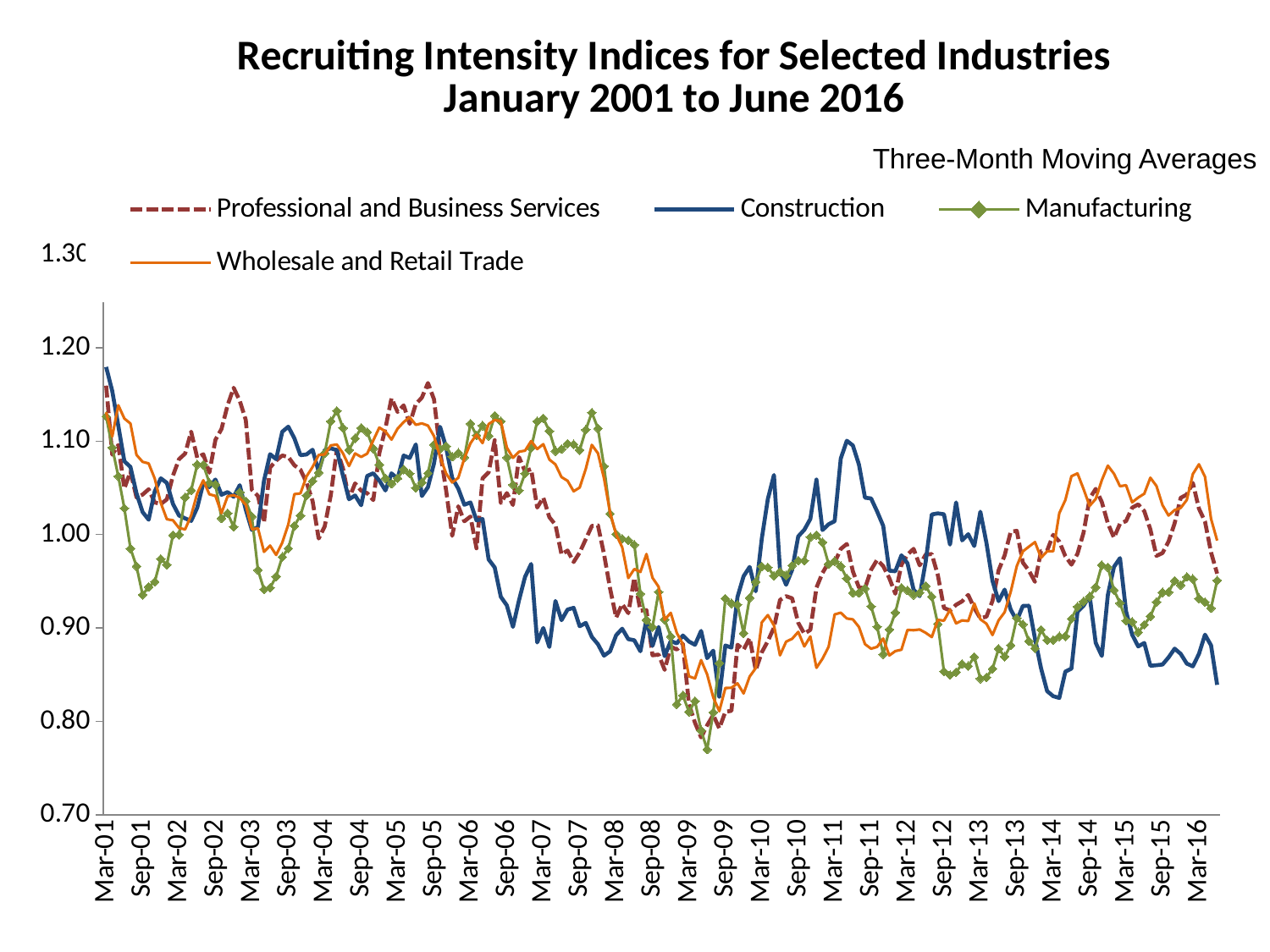
How many series does the legend list? 4 Is the value for Construction at Mar-01 greater or less than 1.10? greater What kind of chart is shown on the slide? line chart Does the Construction series overall rise or fall from Mar-01 to Mar-16? fall Which series is marked with diamond markers? Manufacturing At Sep-11, which is higher: Construction or Manufacturing? Construction Which series is drawn with a dashed line? Professional and Business Services Is the value for Manufacturing at Sep-12 greater or less than 0.90? less At Mar-14, which is higher: Wholesale and Retail Trade or Construction? Wholesale and Retail Trade Is the value for Wholesale and Retail Trade at Mar-16 greater or less than 1.00? greater